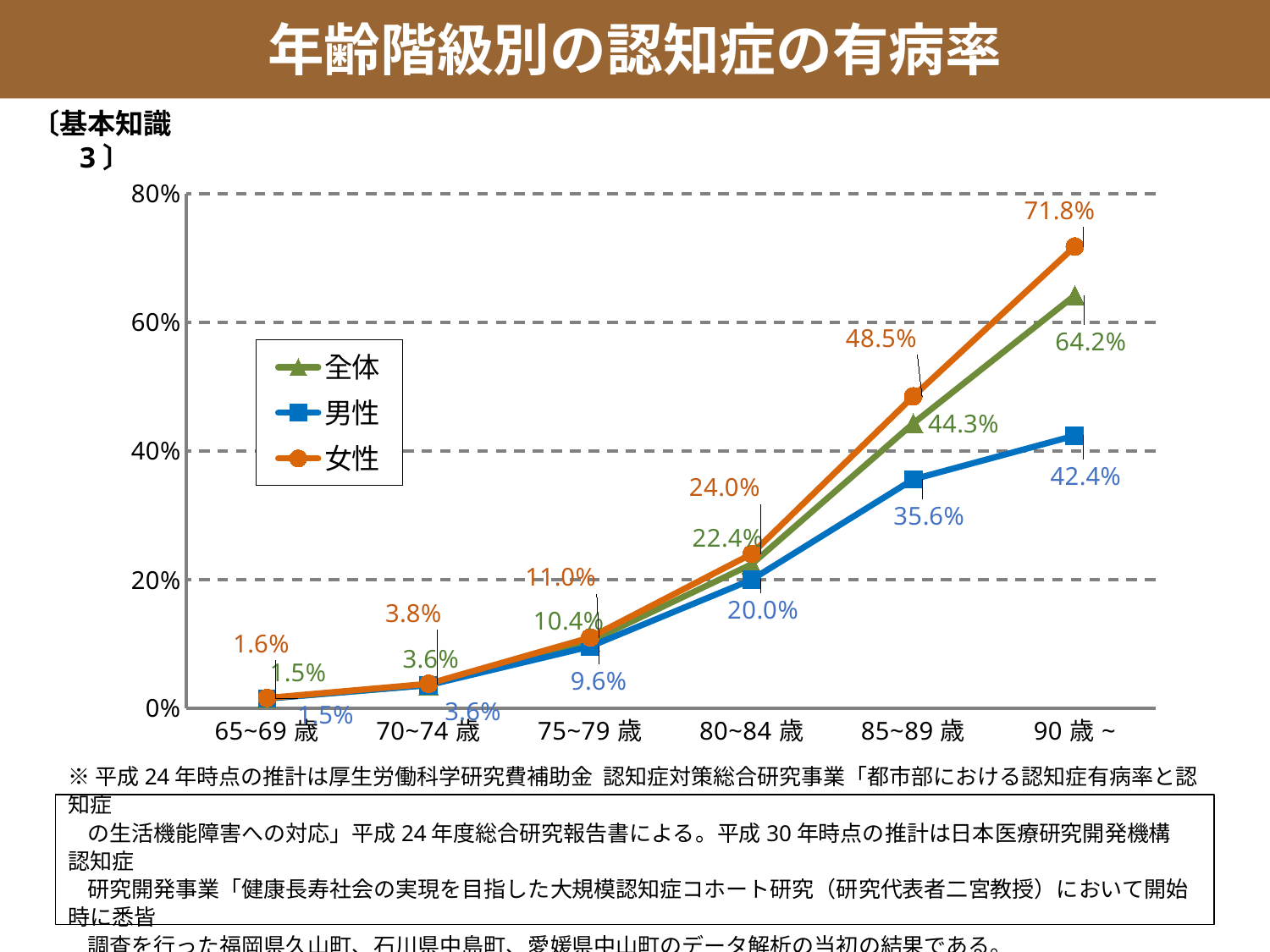
What kind of chart is shown on the slide? line chart Which age group has the lowest value for 女性? 65~69歳 Do the values for 男性 rise or fall as age increases along the x axis? rise What is the value for 全体 in the 80~84歳 age group? 22.4% What is the value for 女性 in the 90歳~ age group? 71.8% How many series does the legend list? 3 How many age categories are shown on the x axis? 6 In the 85~89歳 age group, which is larger, the value for 女性 or the value for 男性? 女性 Which series is drawn with the orange line and circle markers? 女性 What is the difference between the 女性 and 男性 values in the 90歳~ age group? 29.4% What is the value for 男性 in the 85~89歳 age group? 35.6% Which age group has the highest value for 全体? 90歳~